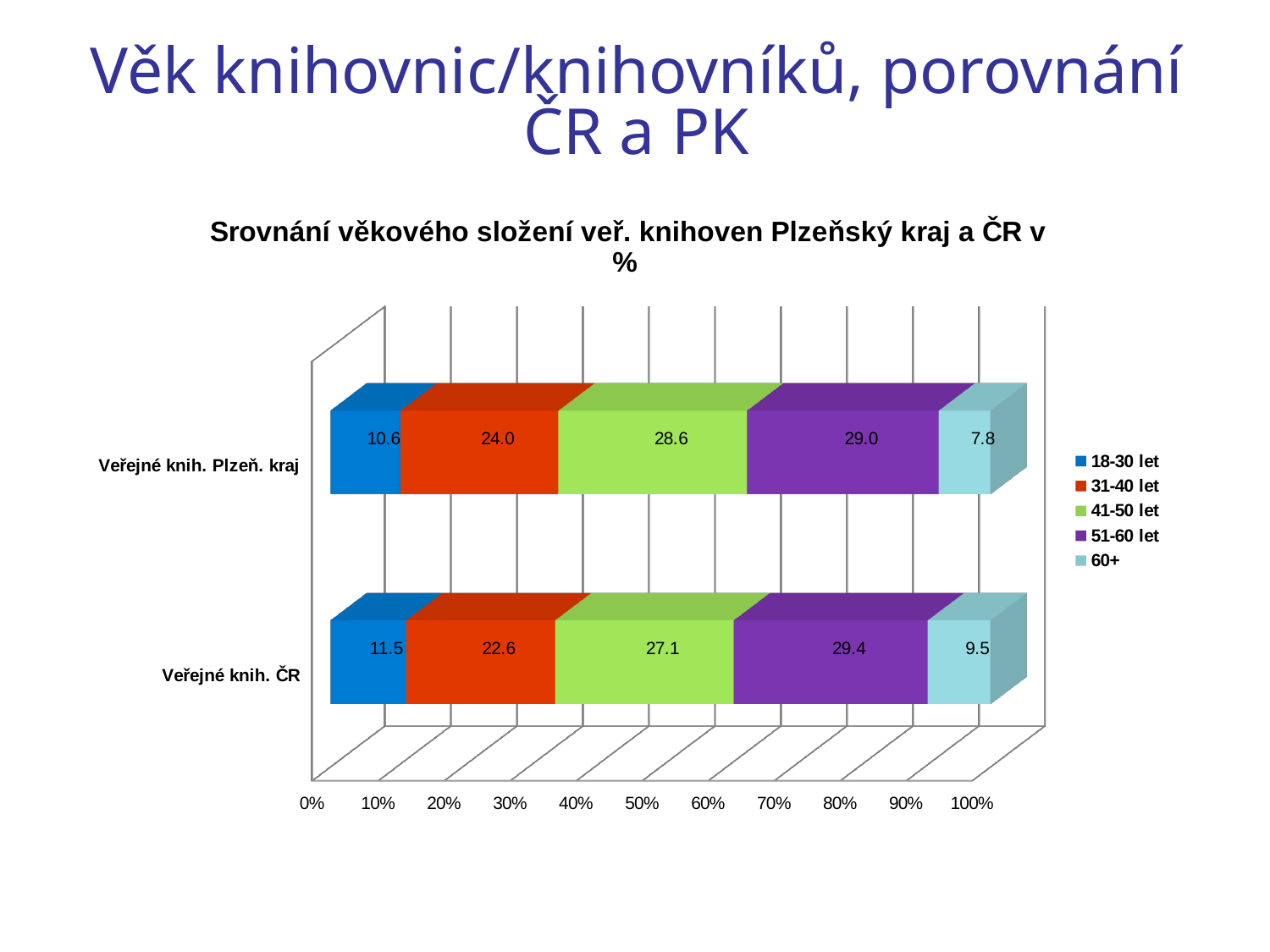
How many series does the legend list? 5 What is the title of the chart? Srovnání věkového složení veř. knihoven Plzeňský kraj a ČR v % How many categories (bars) are shown on the chart? 2 What is the value for the 18-30 let series for Veřejné knih. Plzeň. kraj? 10.6 Which age group has the lowest value for Veřejné knih. ČR? 60+ Which age group has the highest value for Veřejné knih. Plzeň. kraj? 51-60 let What kind of chart is shown on the slide? Stacked bar chart What is the difference between the 31-40 let values for Veřejné knih. Plzeň. kraj and Veřejné knih. ČR? 1.4 What is the value for the 51-60 let series for Veřejné knih. ČR? 29.4 What is the value for the 60+ series for Veřejné knih. Plzeň. kraj? 7.8 What is the value for the 41-50 let series for Veřejné knih. ČR? 27.1 Which has the larger 60+ value, Veřejné knih. Plzeň. kraj or Veřejné knih. ČR? Veřejné knih. ČR